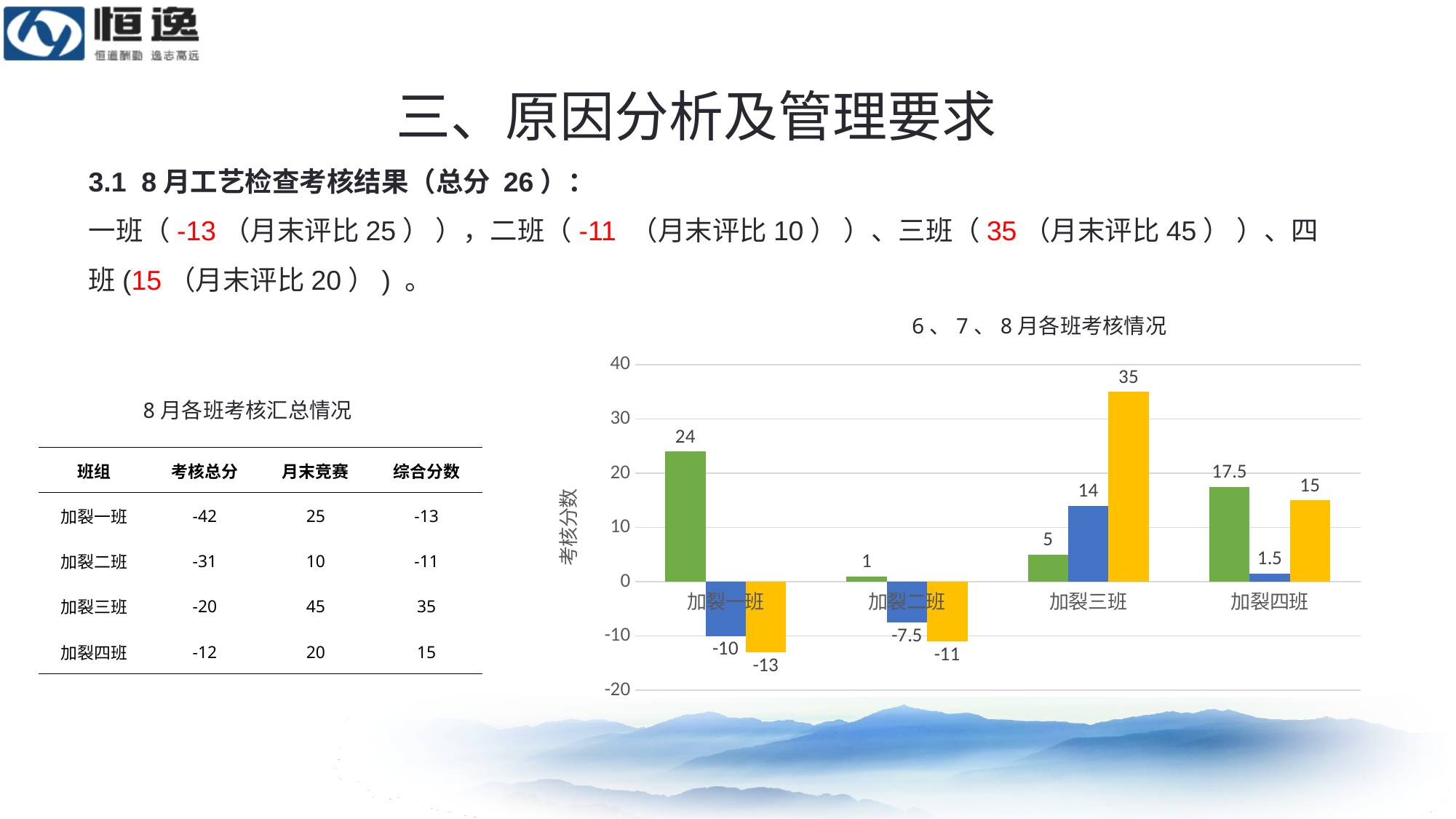
Which category has the highest yellow bar? 加裂三班 What is the value of the green bar for 加裂一班? 24 What is the value of the blue bar for 加裂二班? -7.5 For 加裂三班, what is the difference between the yellow bar and the blue bar? 21 For 加裂四班, what is the difference between the green bar and the yellow bar? 2.5 How many categories (班组) are shown on the x axis of the chart? 4 Is the value of the green bar for 加裂三班 greater or less than 10? less Which category has the lowest blue bar? 加裂一班 What is the value of the yellow bar for 加裂三班? 35 What kind of chart is shown on the slide? bar chart Which is larger: the green bar for 加裂一班 or the green bar for 加裂四班? 加裂一班 What is the title of the chart? 6、7、8月各班考核情况